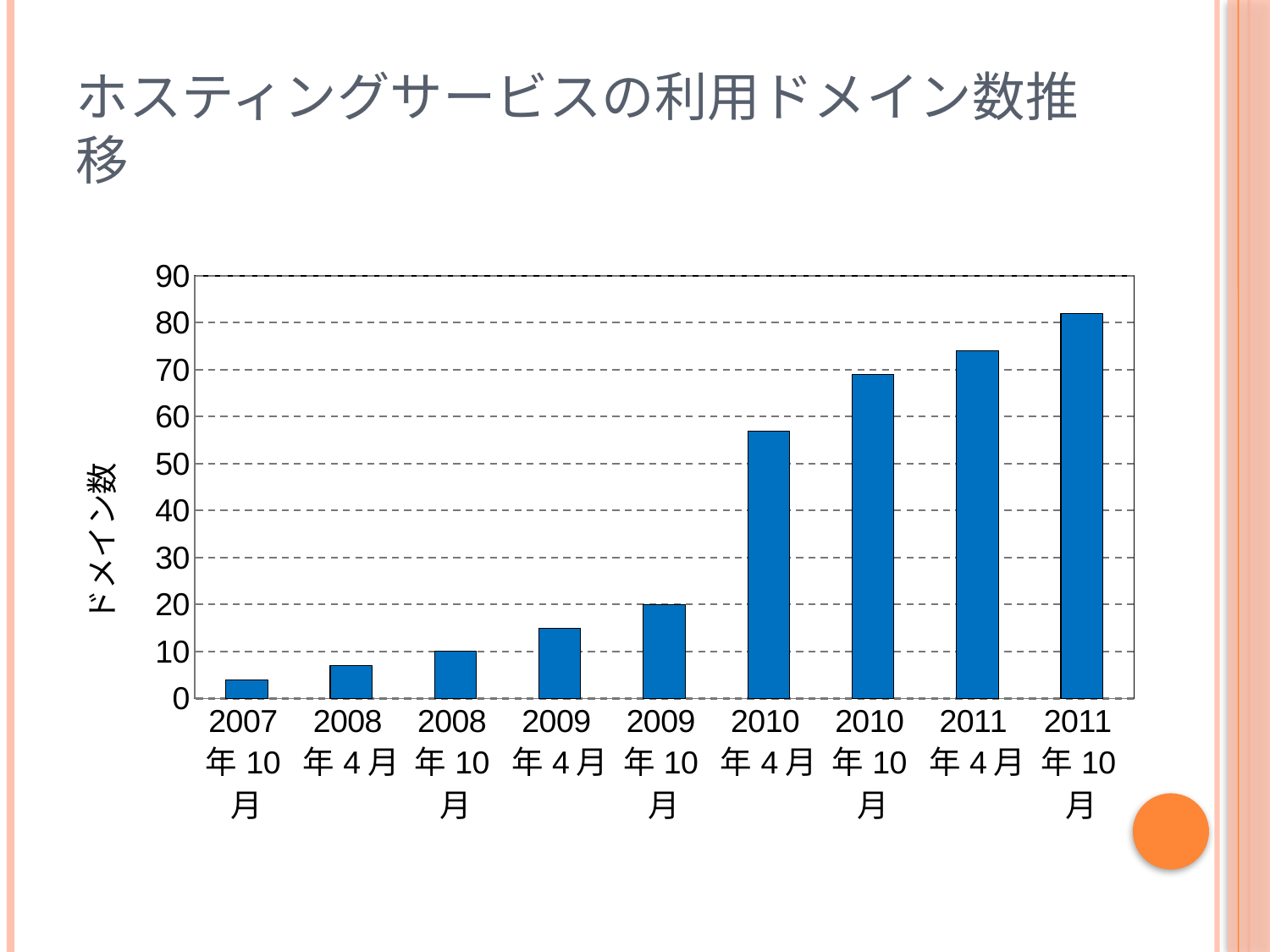
Is the value for 2007年10月 greater or less than 10? less Do the values rise or fall from left to right along the x axis? rise Is the value for 2010年4月 greater or less than 50? greater Which is larger, the value for 2009年4月 or the value for 2010年4月? 2010年4月 How many time periods (bars) are shown on the x axis? 9 Which period has the lowest number of domains? 2007年10月 What kind of chart is shown on the slide? bar chart What is the label of the vertical axis? ドメイン数 What is the title of the slide? ホスティングサービスの利用ドメイン数推移 Which period has the highest number of domains? 2011年10月 Is the value for 2011年10月 greater or less than 80? greater